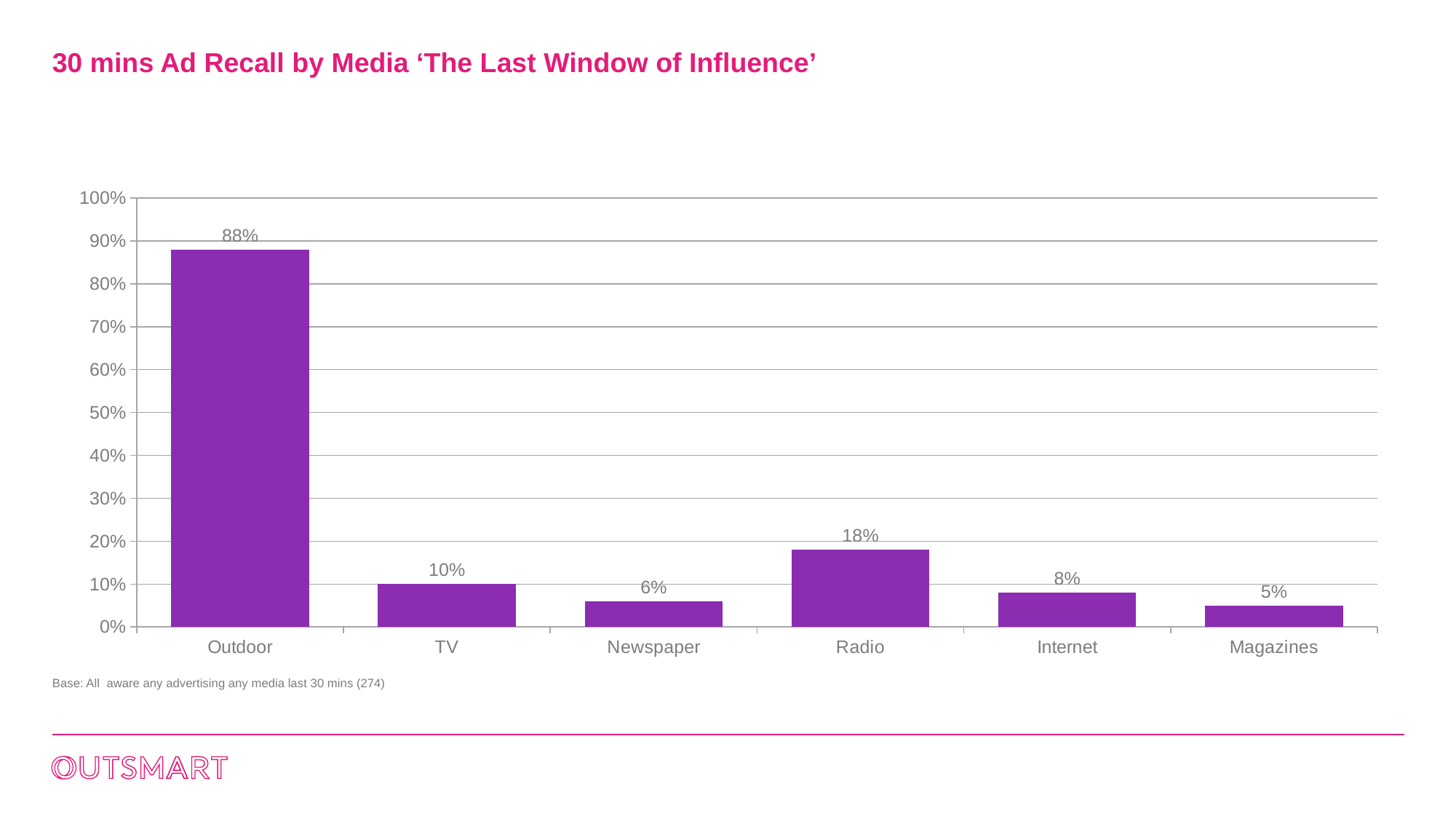
Is the value for Outdoor greater or less than 80%? greater Which media has the highest 30 mins ad recall? Outdoor What is the ad recall value for Magazines? 5% What is the difference between the ad recall for Outdoor and Radio? 70% What kind of chart is shown on the slide? Bar chart What is the 30 mins ad recall value for Outdoor? 88% How many media categories are shown on the chart? 6 What is the title of the chart on the slide? 30 mins Ad Recall by Media 'The Last Window of Influence' What is the difference between the ad recall for TV and Newspaper? 4% Which media has the lowest 30 mins ad recall? Magazines What is the ad recall value for Radio? 18% Which has a higher ad recall, Radio or Internet? Radio